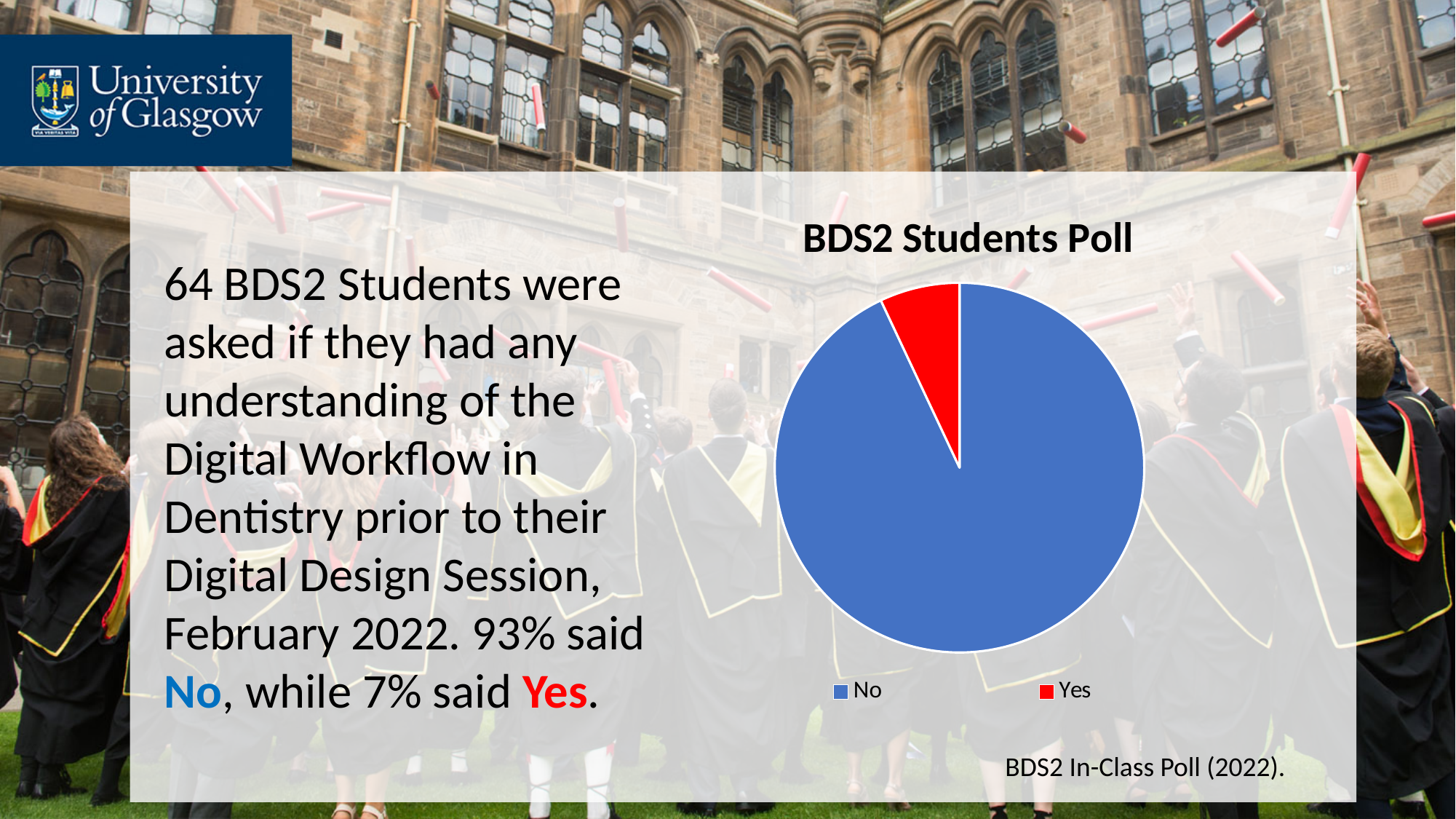
What share of the pie does the No slice represent? 93% How many students were polled according to the slide? 64 Which slice is larger, No or Yes? No What is the title of the chart? BDS2 Students Poll What share of the pie does the Yes slice represent? 7% What colour is the Yes slice in the pie chart? red How many slices does the pie chart have? 2 What kind of chart is shown on the slide? pie chart Which response has the largest slice of the pie? No What is the difference between the No share and the Yes share? 86% How many entries does the legend list? 2 Which response has the smallest slice of the pie? Yes